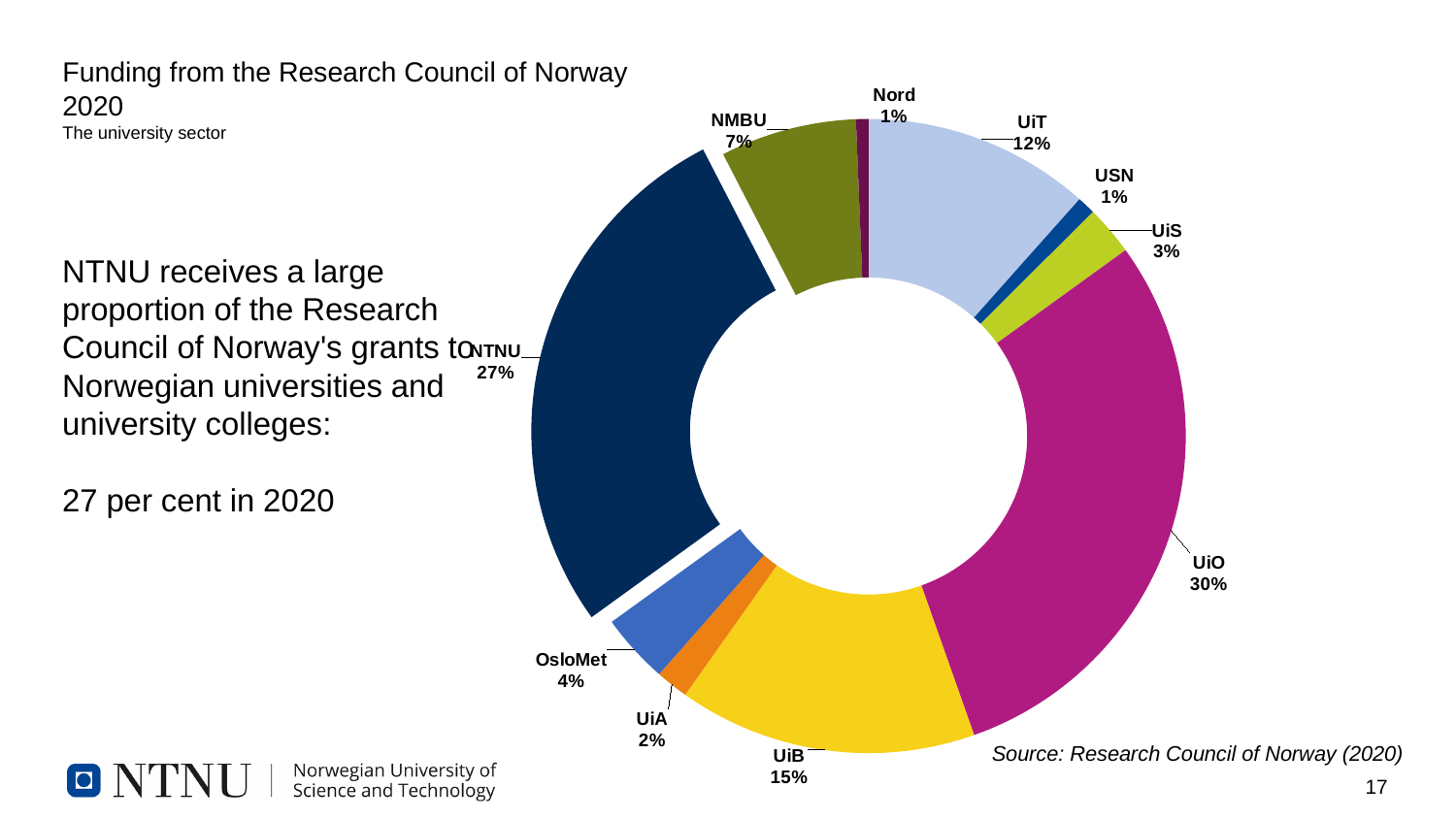
What percentage is shown for OsloMet? 4% How many institutions are shown as slices in the chart? 10 What is the difference in percentage points between UiO's share and NTNU's share? 3 What is the difference in percentage points between UiT and NMBU? 5 Which has a larger share, UiT or UiB? UiB What percentage is shown for NMBU? 7% What kind of chart is shown on the slide? Doughnut (pie) chart What is the source cited for the chart? Research Council of Norway (2020) What percentage is shown for UiO in the chart? 30% What share of the Research Council of Norway funding does NTNU receive according to the chart? 27% Which institution has the largest share in the chart? UiO What percentage is shown for UiB? 15%